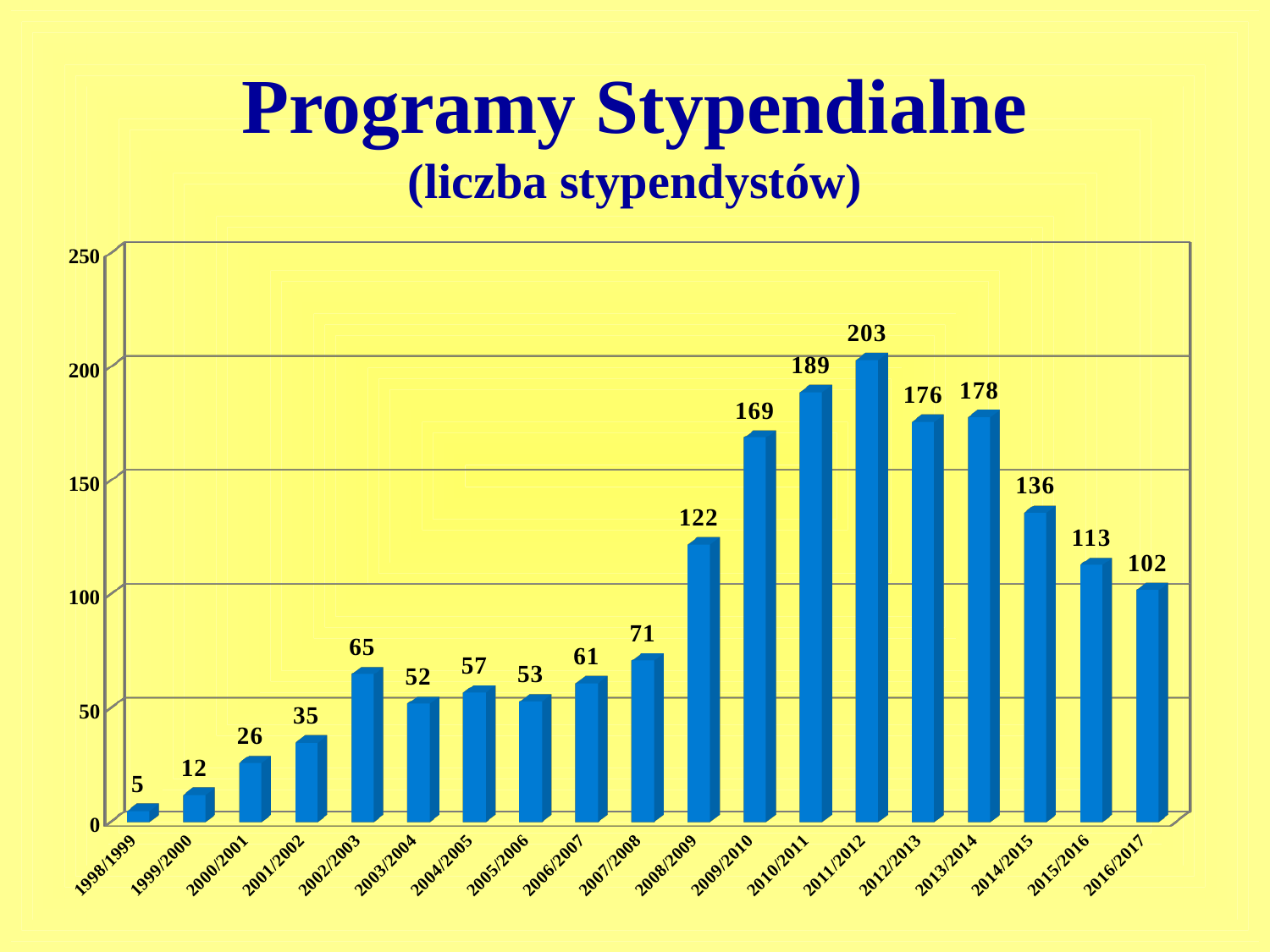
What is the number of scholarship holders for 2011/2012? 203 What kind of chart is shown on the slide? bar chart Do the values rise or fall from 2011/2012 to 2016/2017? fall Which academic year has the lowest number of scholarship holders? 1998/1999 Which is larger, the value for 2013/2014 or the value for 2012/2013? 2013/2014 Is the value for 2008/2009 greater or less than 100? greater What is the title of the chart? Programy Stypendialne (liczba stypendystów) How many academic years are shown on the x axis? 19 What is the value shown for 2002/2003? 65 Which academic year has the highest number of scholarship holders? 2011/2012 What is the difference between the values for 2010/2011 and 2009/2010? 20 What is the value shown for 2016/2017? 102